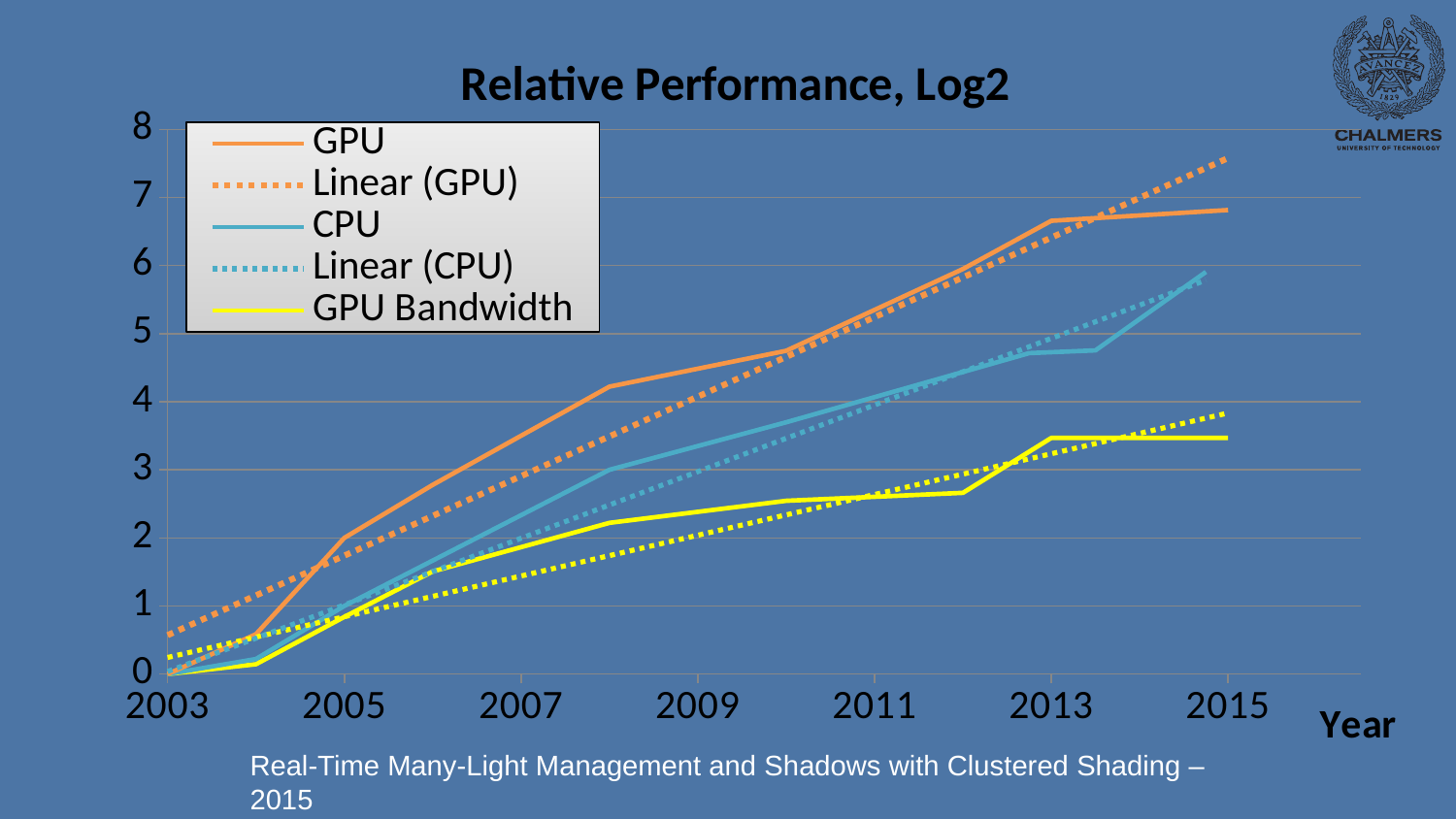
What is the label of the x axis? Year How many series does the legend list? 5 What kind of chart is shown on the slide? line chart In 2011, which is larger, the GPU value or the CPU value? GPU Is the value for GPU in 2009 greater or less than 4? greater What is the title of the chart? Relative Performance, Log2 Is the value for GPU Bandwidth in 2015 greater or less than 4? less Which series has the highest value in 2015? GPU Do the GPU values rise or fall from 2003 to 2015? rise Which series has the lowest value in 2015? GPU Bandwidth Is the value for GPU in 2015 greater or less than 6? greater